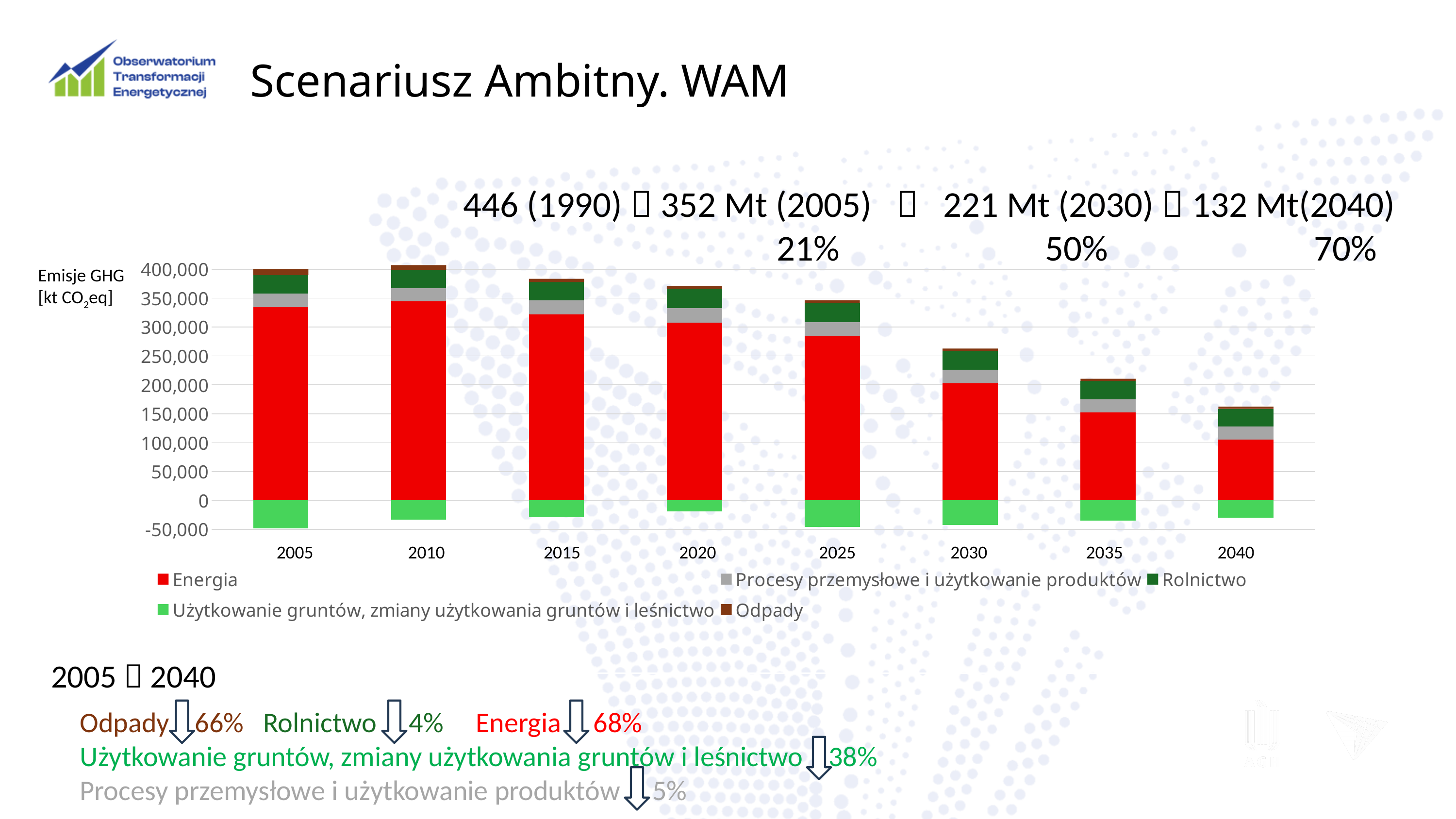
Is the Energia value for 2030 greater or less than 250,000? less How many years are shown on the x axis of the chart? 8 Is the Energia value for 2005 greater or less than 300,000? greater How many series does the chart legend list? 5 Which is larger, the Energia value for 2010 or for 2040? 2010 Is the Energia value for 2035 greater or less than 100,000? greater What colour represents the Energia series in the chart? red Does the Energia value rise or fall from 2005 to 2040? fall Which year has the lowest Energia value? 2040 What kind of chart is shown on the slide? bar chart What is the label on the vertical axis of the chart? Emisje GHG [kt CO2eq]